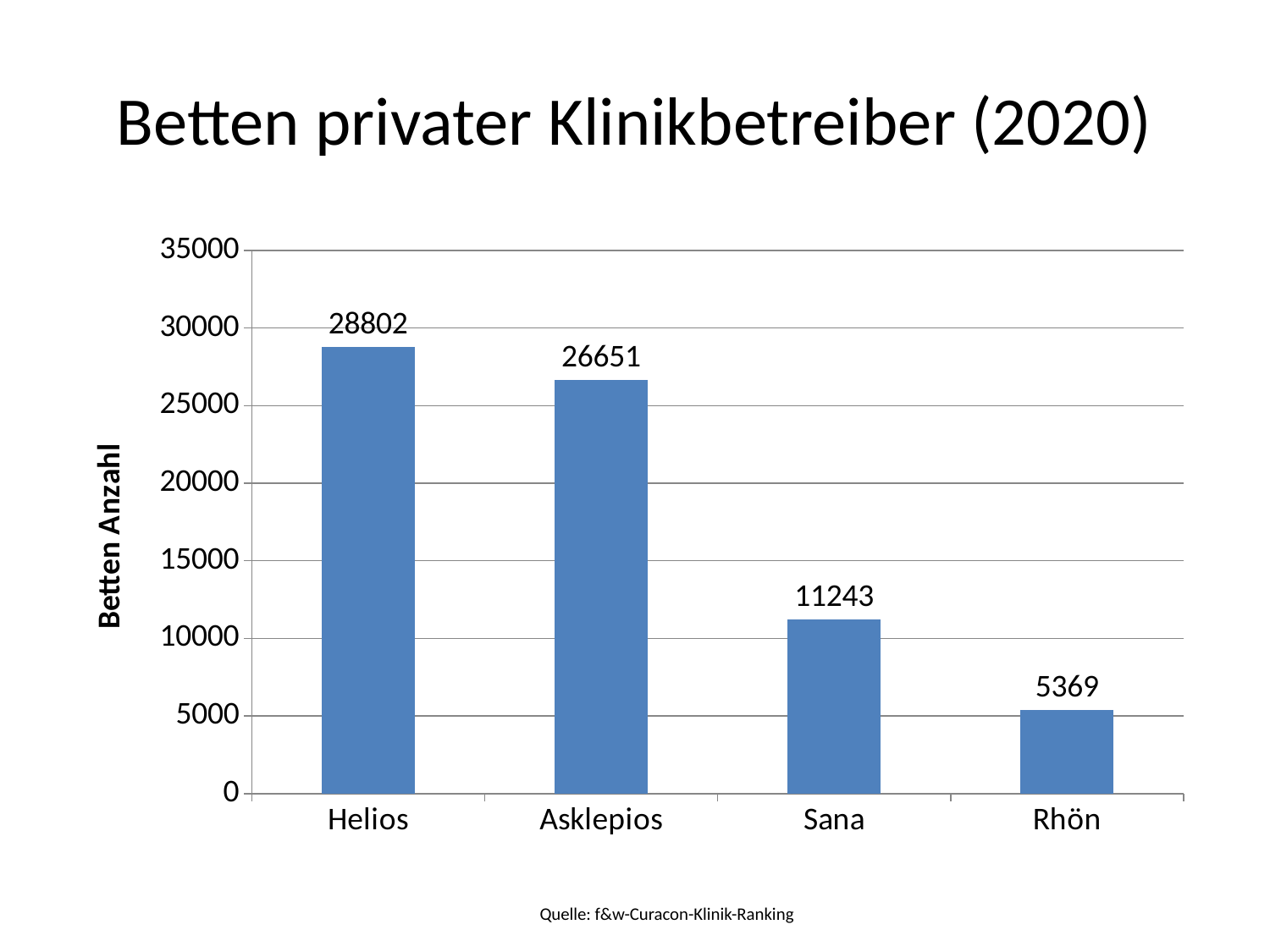
Which operator has the lowest number of beds? Rhön Which operator has the highest number of beds? Helios What is the title of the chart on the slide? Betten privater Klinikbetreiber (2020) How many operators are shown on the chart? 4 What kind of chart is shown on the slide? Bar chart What is the difference in beds between Helios and Asklepios? 2151 How many beds does Helios have according to the chart? 28802 What is the value shown for Rhön? 5369 What is the value shown for Asklepios? 26651 Which has more beds, Asklepios or Sana? Asklepios What is the value shown for Sana? 11243 What is the difference in beds between Sana and Rhön? 5874